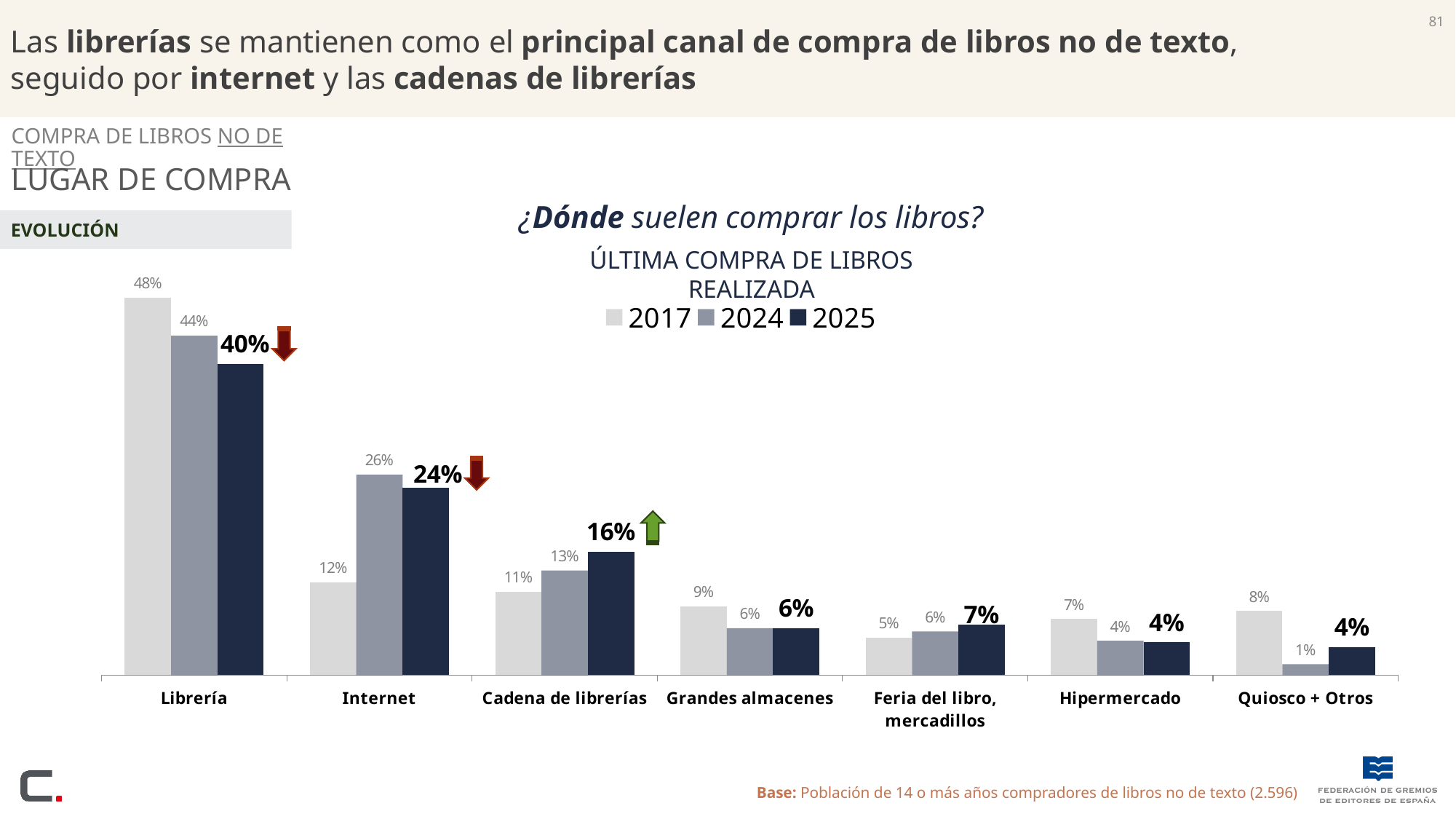
Which category has the lowest 2024 value? Quiosco + Otros How many categories are shown on the x axis? 7 What kind of chart is shown? Bar chart Which is larger for Cadena de librerías: the 2024 value or the 2025 value? 2025 Which category has the highest 2025 value? Librería Did the value for Internet rise or fall from 2024 to 2025? Fall What is the 2024 value for Quiosco + Otros? 1% Which years are listed in the legend? 2017, 2024, 2025 What is the 2017 value for Internet? 12% What is the difference between the 2017 and 2025 values for Librería? 8% What is the 2025 value for Librería? 40% How many series does the legend list? 3